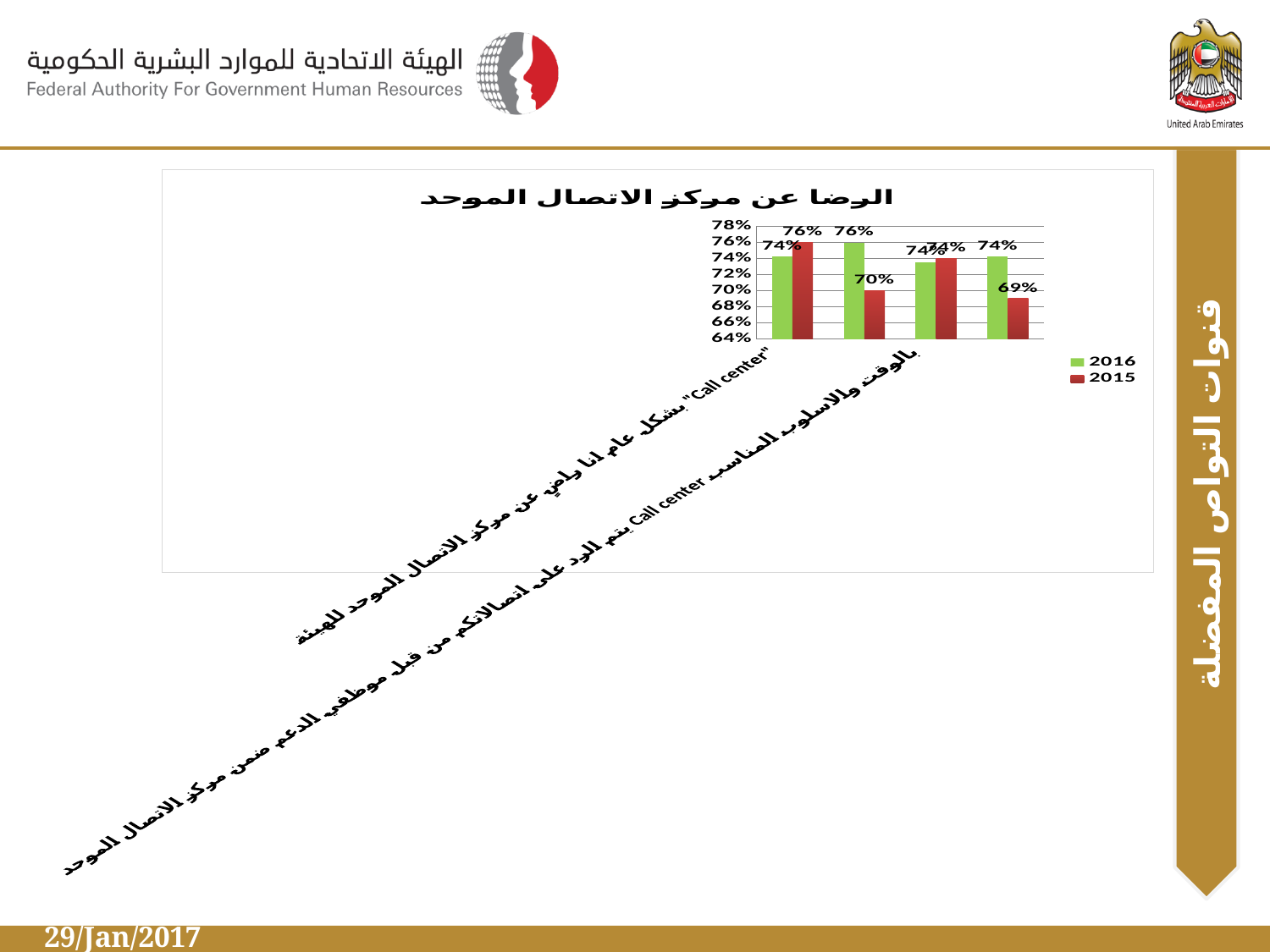
What is the 2015 value for the second group of bars from the left? 70% In the second group of bars from the left, what is the difference between the 2016 and 2015 values? 6 percentage points Which group of bars has the lowest 2015 value? The fourth (rightmost) group, 69% What is the 2016 value for the second group of bars from the left? 76% How many groups of bars are plotted in the chart? 4 How many series does the chart legend list? 2 Which years are listed in the chart legend? 2016 and 2015 What is the 2015 value for the first (leftmost) group of bars? 76% What kind of chart is shown on the slide? Bar chart What is the 2015 value for the fourth (rightmost) group of bars? 69% In the first (leftmost) group of bars, which series has the larger value, 2016 or 2015? 2015 Is the 2015 value for the rightmost group of bars greater or less than 70%? less